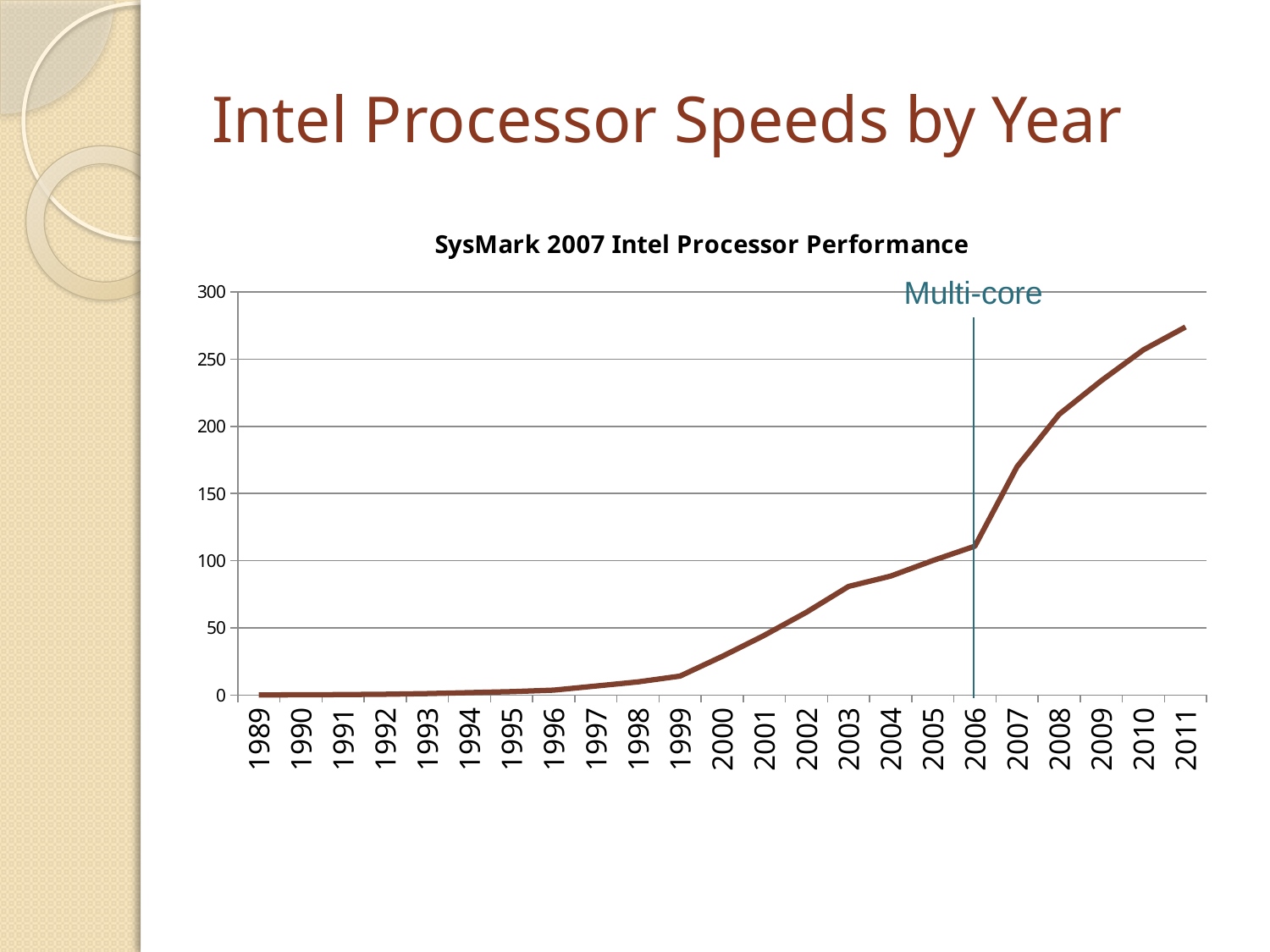
Which year has the larger value, 2003 or 2009? 2009 Which year has the highest value? 2011 Is the value for 2011 greater or less than 250? greater Is the value for 2007 greater or less than 150? greater What is the title of the chart? SysMark 2007 Intel Processor Performance Is the value for 2003 greater or less than 50? greater How many years are plotted along the x axis? 23 At which year is the vertical line labelled "Multi-core" placed? 2006 What kind of chart is shown on the slide? line chart Do the values rise or fall from 1989 to 2011? rise